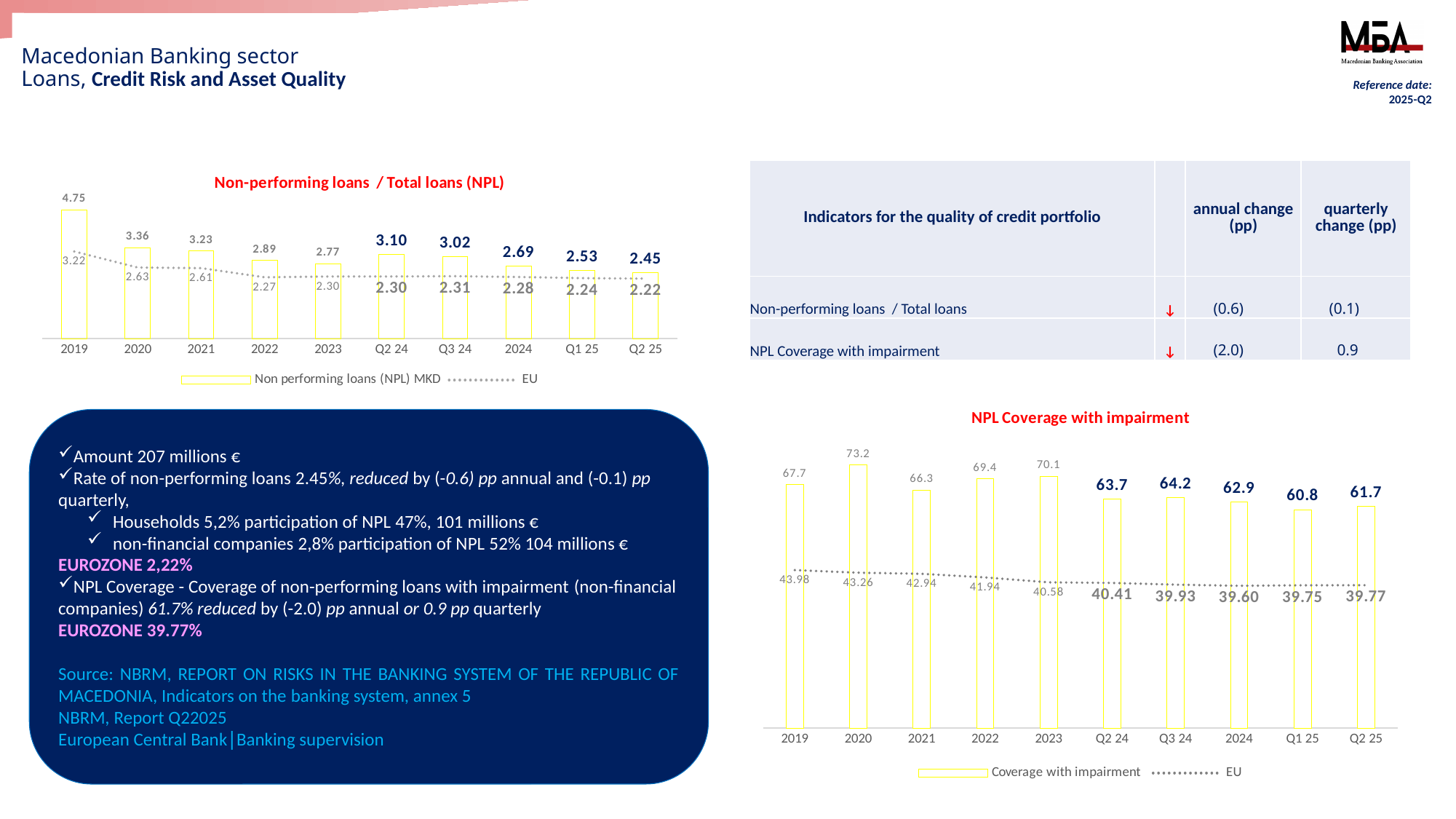
In the 'Non-performing loans / Total loans (NPL)' chart, how many series does the legend list? 2 In the 'NPL Coverage with impairment' chart, what is the EU value for Q2 25? 39.77 In the 'Non-performing loans / Total loans (NPL)' chart, how many categories are shown on the x axis? 10 In the 'NPL Coverage with impairment' chart, what is the difference between the coverage bar for Q2 25 and the EU value for Q2 25? 21.93 In the 'Non-performing loans / Total loans (NPL)' chart, what is the EU value for 2019? 3.22 In the 'NPL Coverage with impairment' chart, what is the coverage value for 2020? 73.2 What kind of chart is the 'NPL Coverage with impairment' chart? Bar chart with a line In the 'NPL Coverage with impairment' chart, which is larger: the coverage bar for Q3 24 or for 2024? Q3 24 In the 'Non-performing loans / Total loans (NPL)' chart, what is the difference between the NPL bar for 2019 and the NPL bar for 2020? 1.39 In the 'Non-performing loans / Total loans (NPL)' chart, what is the NPL value for Q2 25? 2.45 In the 'NPL Coverage with impairment' chart, which category has the lowest coverage bar? Q1 25 In the 'Non-performing loans / Total loans (NPL)' chart, which category has the highest NPL bar? 2019